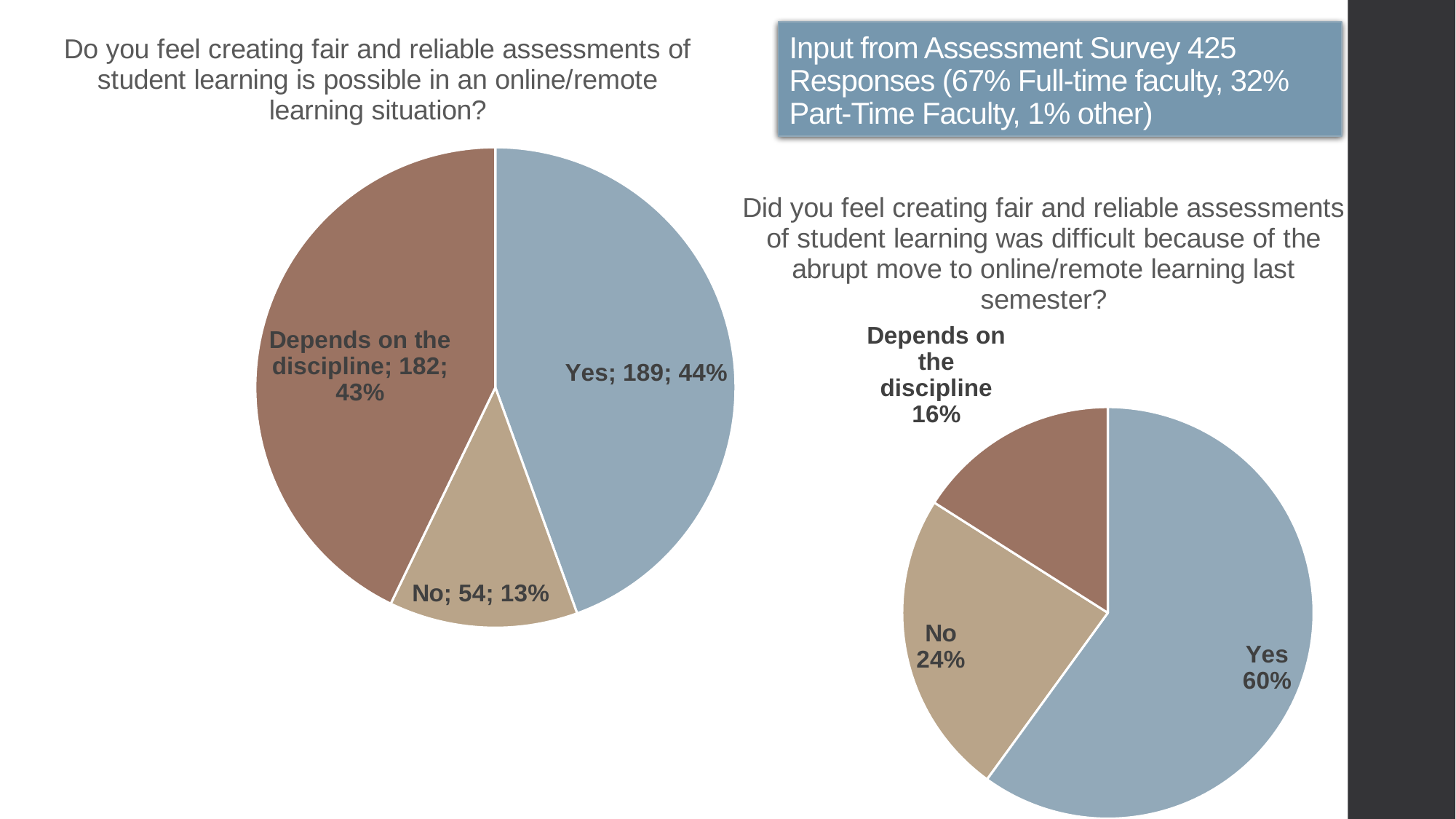
What type of chart is used on the right side of the slide? Pie chart In the left pie chart, how many responses were "No"? 54 In the left pie chart ("Do you feel creating fair and reliable assessments... is possible..."), how many responses were "Yes"? 189 In the right pie chart, which response has the smallest slice? Depends on the discipline In the right pie chart, what is the difference in percentage points between "Yes" and "No"? 36 In the left pie chart, how many response categories are shown? 3 In the left pie chart, what is the difference in the number of responses between "Yes" and "Depends on the discipline"? 7 In the left pie chart, which response has the largest slice? Yes In the right pie chart, what percentage of responses were "No"? 24% In the left pie chart, which response has the smallest slice? No In the right pie chart ("Did you feel creating fair and reliable assessments... was difficult..."), what share of responses were "Yes"? 60% In the left pie chart, what percentage of responses were "Depends on the discipline"? 43%